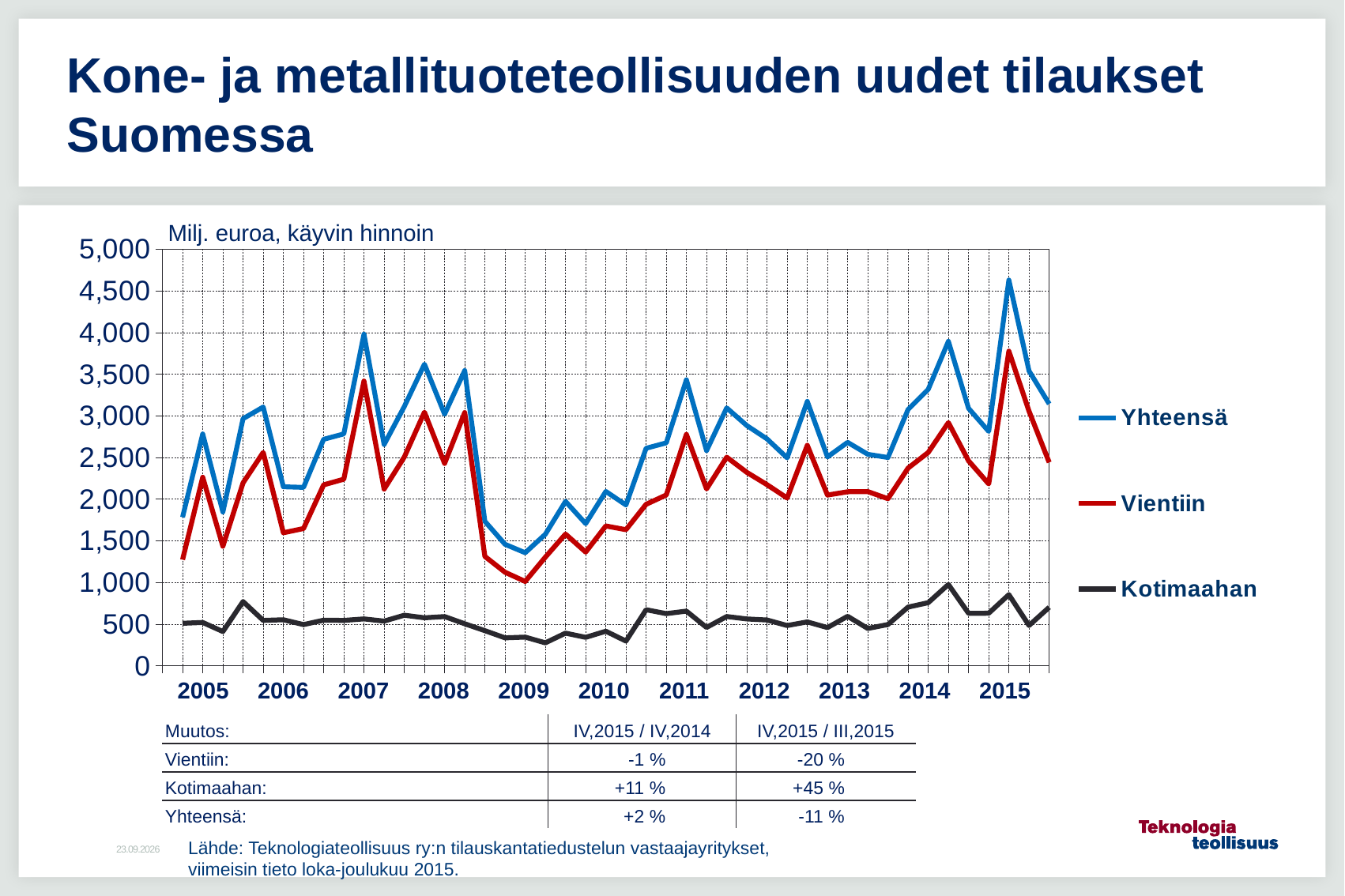
In which year does the Yhteensä line reach its highest peak? 2015 How many series does the chart legend list? 3 Which series is higher in 2007, Yhteensä or Kotimaahan? Yhteensä According to the table below the chart, what is the change in Kotimaahan for IV,2015 / III,2015? +45 % Which series has the lowest values throughout the chart? Kotimaahan Is the highest peak of the Yhteensä line greater or less than 4,000? greater What are the three series named in the chart legend? Yhteensä, Vientiin, Kotimaahan Is the Kotimaahan line ever greater or less than 1,500 over the whole period? less Is the lowest point of the Vientiin line, in 2009, greater or less than 1,500? less How many year labels are shown on the x axis of the chart? 11 What kind of chart is shown on the slide? line chart What unit is given above the chart's y axis? Milj. euroa, käyvin hinnoin